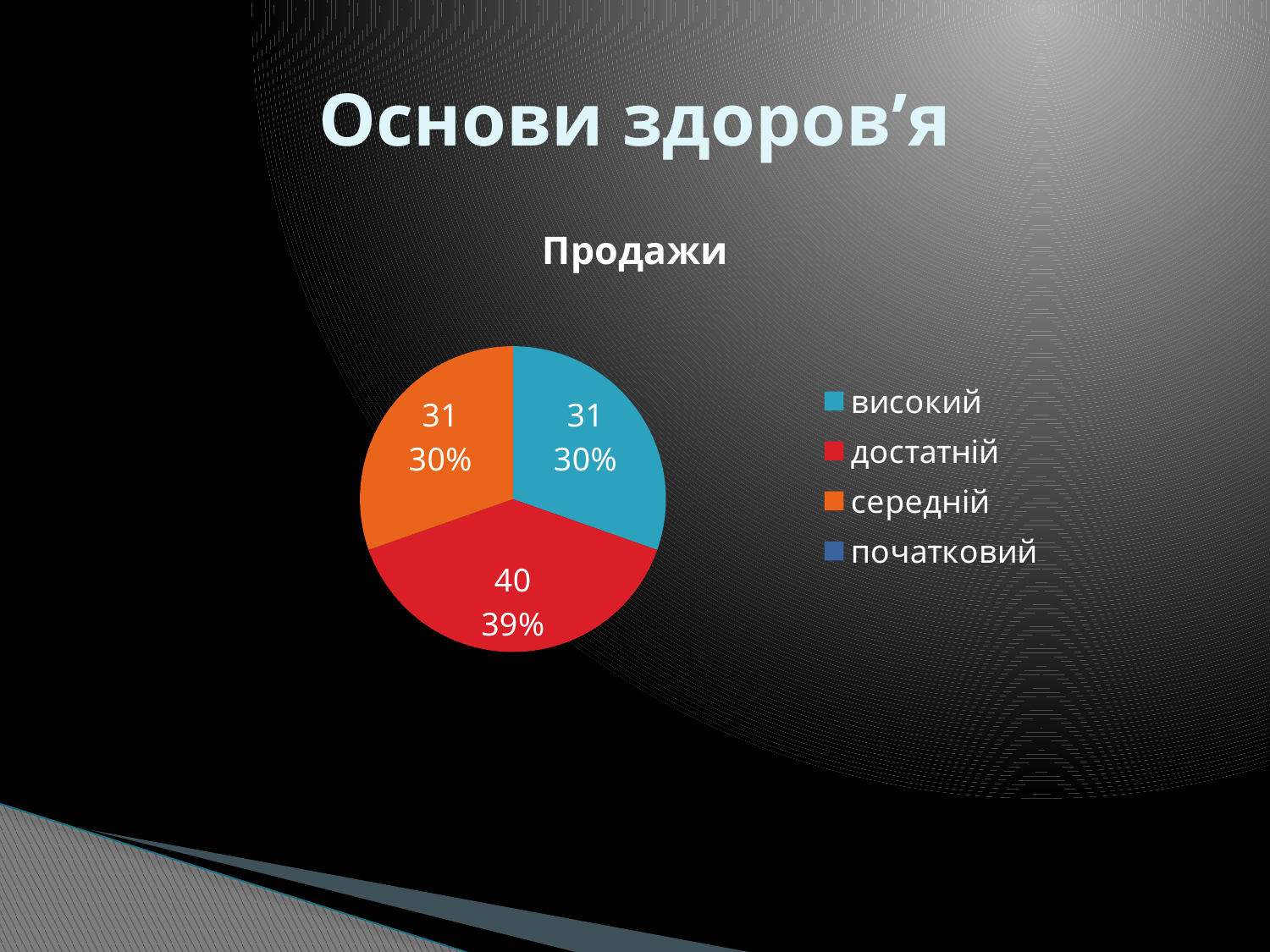
Which is larger, the value for достатній or the value for високий? достатній What is the title of the chart? Продажи Which category has the largest slice in the pie chart? достатній What percentage share of the pie does the достатній slice have? 39% How many slices are visible in the pie chart? 3 What is the value shown for the достатній slice of the pie chart? 40 What percentage share of the pie does the високий slice have? 30% What is the value shown for the високий slice of the pie chart? 31 What kind of chart is shown on the slide? pie chart What is the value shown for the середній slice of the pie chart? 31 What is the difference between the values for достатній and середній? 9 How many entries does the legend of the chart list? 4